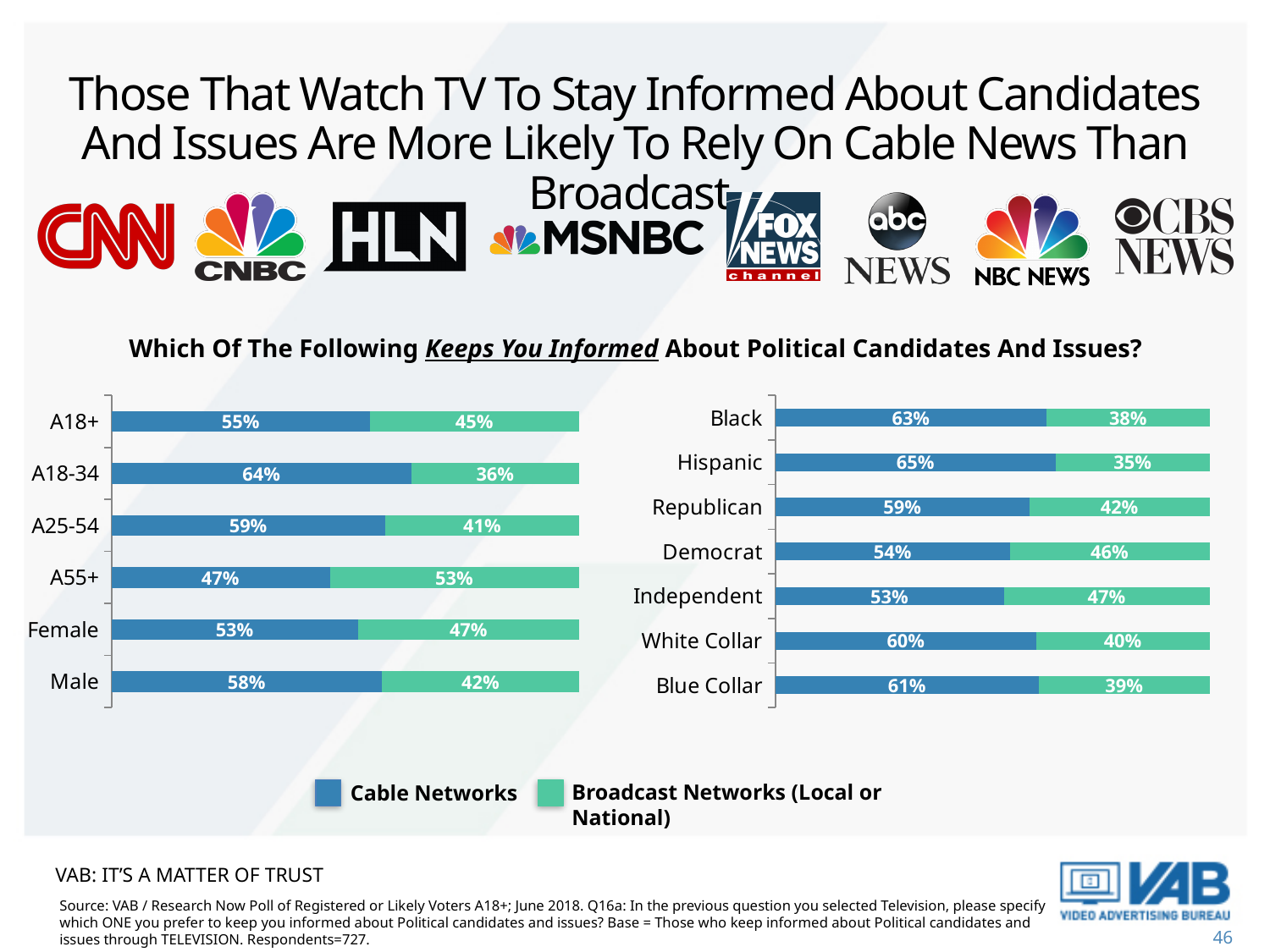
In the left chart, what is the total of the stacked bar for A25-54? 100% How many series does the legend list? 2 In the right chart, what is the Cable Networks value for Hispanic? 65% In the left chart, what is the difference between the Cable Networks values for Male and Female? 5% In the left chart, which category has the lowest Cable Networks value? A55+ In the right chart, what is the Broadcast Networks value for Democrat? 46% What type of chart is used on the slide? Bar chart How many categories are shown in the right chart? 7 In the right chart, which category has the highest Cable Networks value? Hispanic In the left chart, what is the Broadcast Networks value for A55+? 53% In the right chart, which is larger: the Cable Networks value for Republican or for Independent? Republican In the left chart, what is the Cable Networks value for A18-34? 64%